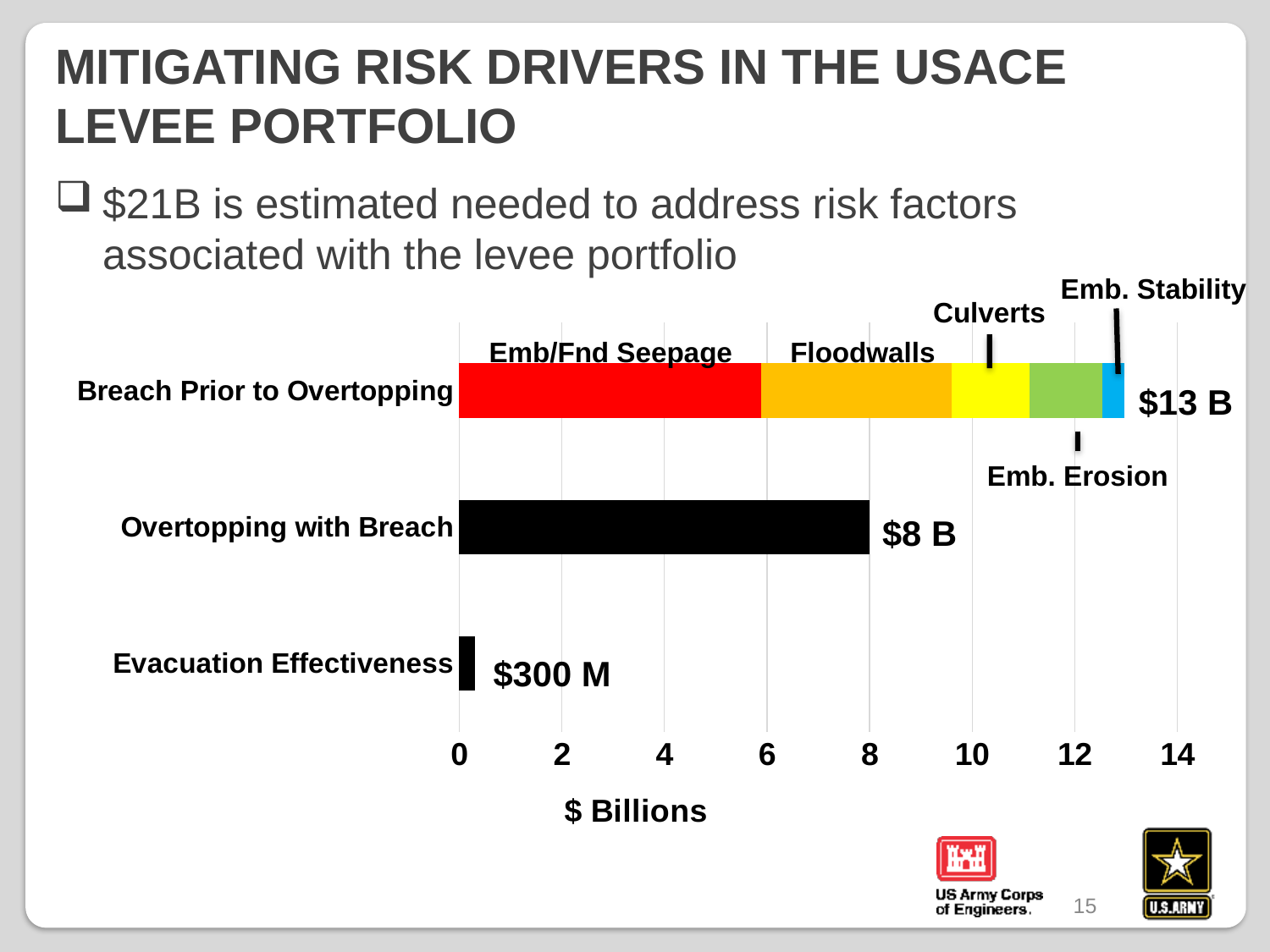
Which segment of the Breach Prior to Overtopping bar is coloured red? Emb/Fnd Seepage What is the value shown for Overtopping with Breach? $8 B Which category has the lowest value? Evacuation Effectiveness Which category has the highest value? Breach Prior to Overtopping What kind of chart is shown on the slide? bar chart What is the difference between the values for Breach Prior to Overtopping and Overtopping with Breach? $5 B How many categories are shown on the chart? 3 What is the value shown for Breach Prior to Overtopping? $13 B What is the value shown for Evacuation Effectiveness? $300 M What is the title of the horizontal axis? $ Billions Is the value for Evacuation Effectiveness greater or less than 2? less Which is larger, the value for Overtopping with Breach or the value for Evacuation Effectiveness? Overtopping with Breach